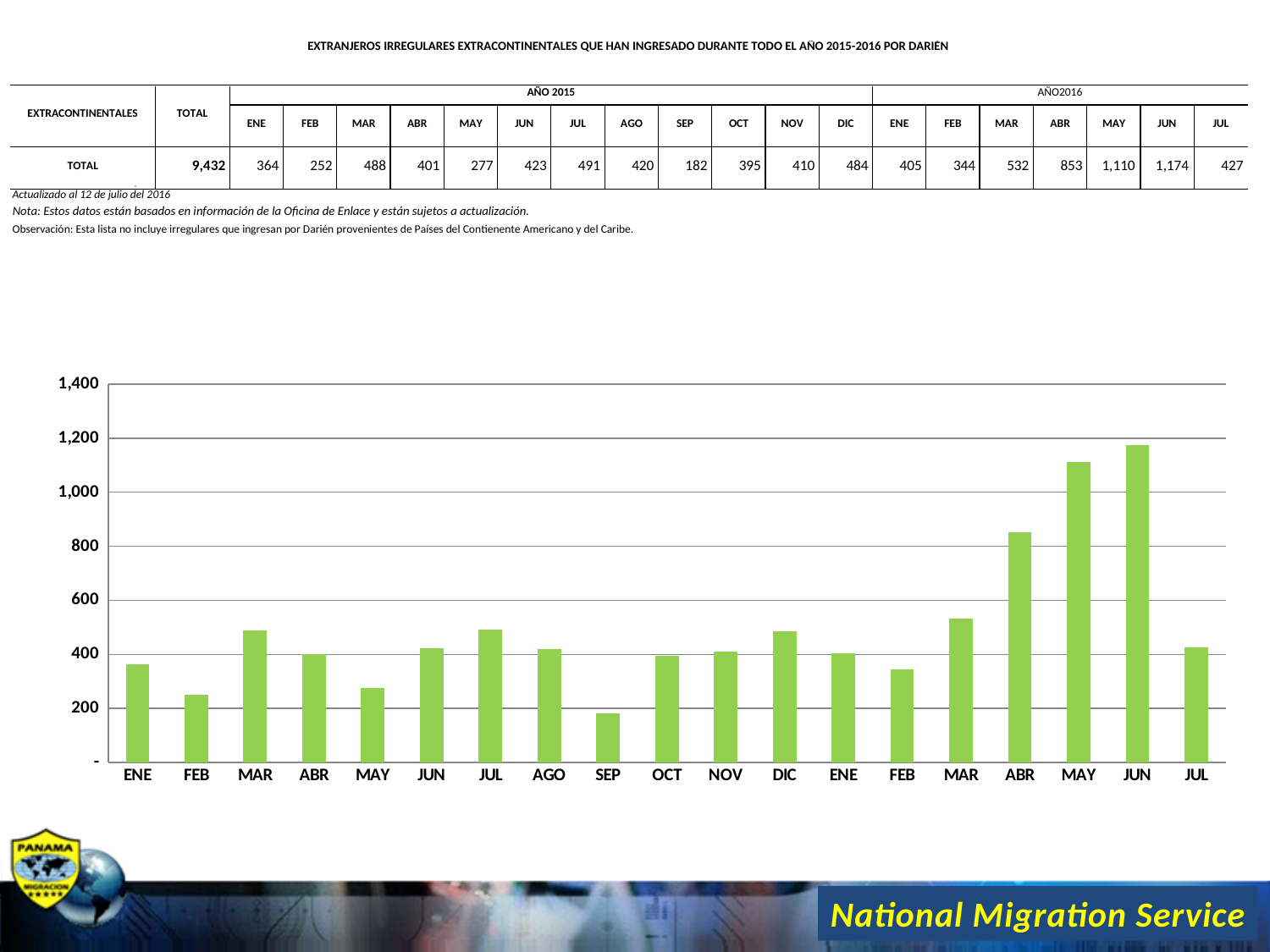
Is the bar for FEB 2015 greater or less than 400? less Which is larger, the value for MAR 2016 or the value for MAR 2015? MAR 2016 What is the overall TOTAL shown in the table? 9,432 What kind of chart is shown on the slide? bar chart What is the difference between the values for JUN 2016 and MAY 2016 in the table? 64 According to the table, what is the value for SEP 2015? 182 Which month has the highest bar in the chart? JUN 2016 According to the table, what is the value for ABR 2016? 853 Is the bar for MAY 2016 greater or less than 1,000? greater How many bars are plotted in the chart? 19 Which month has the lowest bar in the chart? SEP 2015 According to the table, what is the value for JUN 2016? 1,174